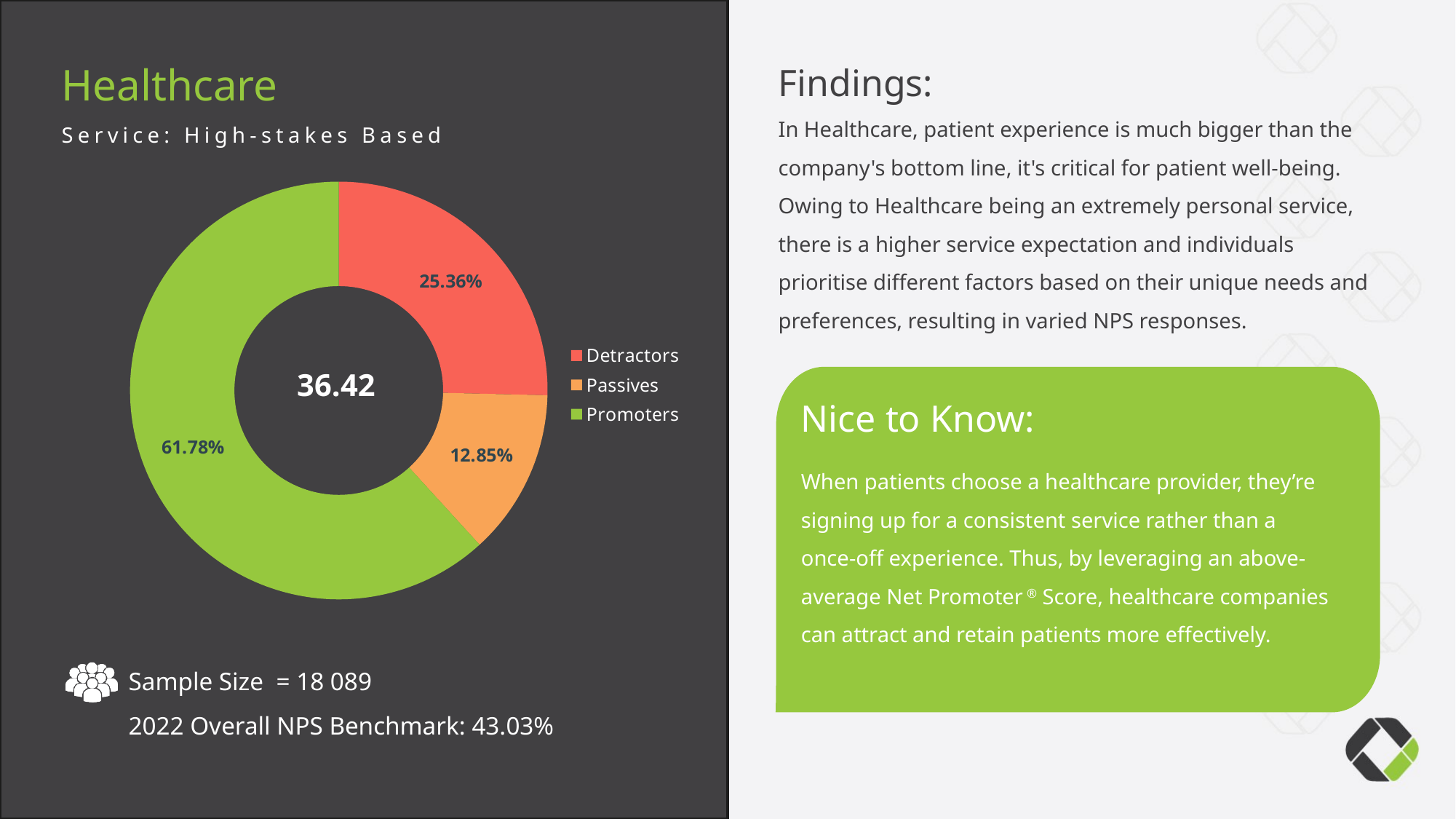
What is the difference in percentage points between Detractors and Passives in the donut chart? 12.51 What kind of chart is shown on the slide? Donut (pie) chart Which is larger in the donut chart, Detractors or Passives? Detractors What percentage of the donut chart is Passives? 12.85% Which colour represents Passives in the donut chart? Orange Which category has the smallest share of the donut chart? Passives What is the difference in percentage points between Promoters and Detractors in the donut chart? 36.42 What percentage of the donut chart is Detractors? 25.36% What percentage of the donut chart is Promoters? 61.78% How many categories does the donut chart show? 3 Which category has the largest share of the donut chart? Promoters What number is displayed in the centre of the donut chart? 36.42